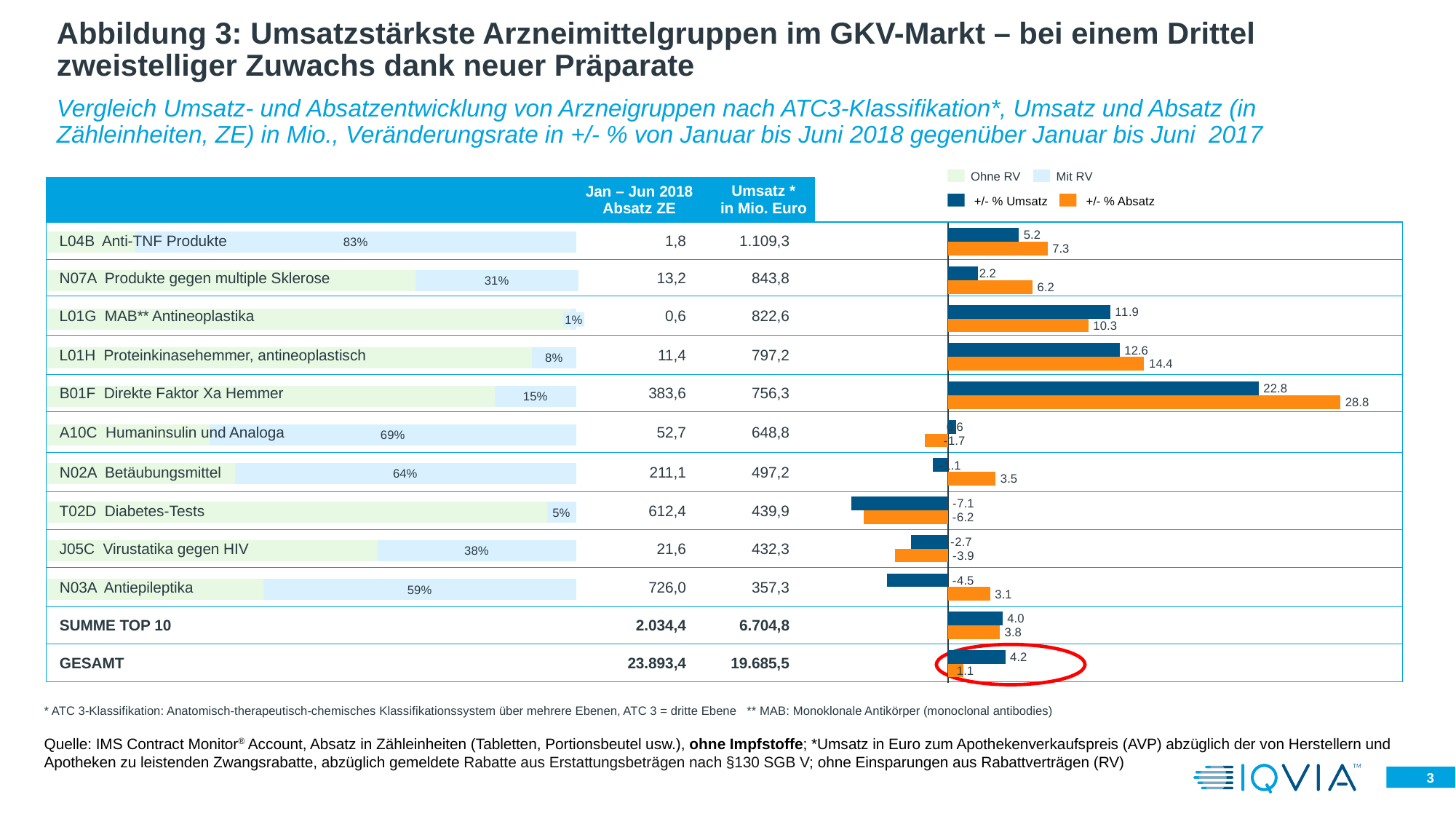
What kind of chart is used on the right side of the slide to show the +/- % Umsatz and +/- % Absatz values? bar chart In the right-hand bar chart, what colour are the +/- % Absatz bars? orange In the right-hand bar chart, which is larger for L01G MAB** Antineoplastika: the +/- % Umsatz value or the +/- % Absatz value? +/- % Umsatz In the right-hand bar chart, what is the +/- % Absatz value for SUMME TOP 10? 3.8 In the right-hand bar chart, which category has the highest +/- % Absatz value? B01F Direkte Faktor Xa Hemmer In the right-hand bar chart, what is the +/- % Umsatz value for J05C Virustatika gegen HIV? -2.7 In the right-hand bar chart, what is the +/- % Umsatz value for GESAMT? 4.2 In the right-hand bar chart, which category has the lowest +/- % Umsatz value? T02D Diabetes-Tests In the right-hand bar chart, what is the +/- % Umsatz value for B01F Direkte Faktor Xa Hemmer? 22.8 In the right-hand bar chart, what is the +/- % Absatz value for L01H Proteinkinasehemmer, antineoplastisch? 14.4 How many series does the legend of the right-hand bar chart list for the percentage change bars? 2 In the right-hand bar chart, what is the difference between the +/- % Absatz and +/- % Umsatz values for B01F Direkte Faktor Xa Hemmer? 6.0